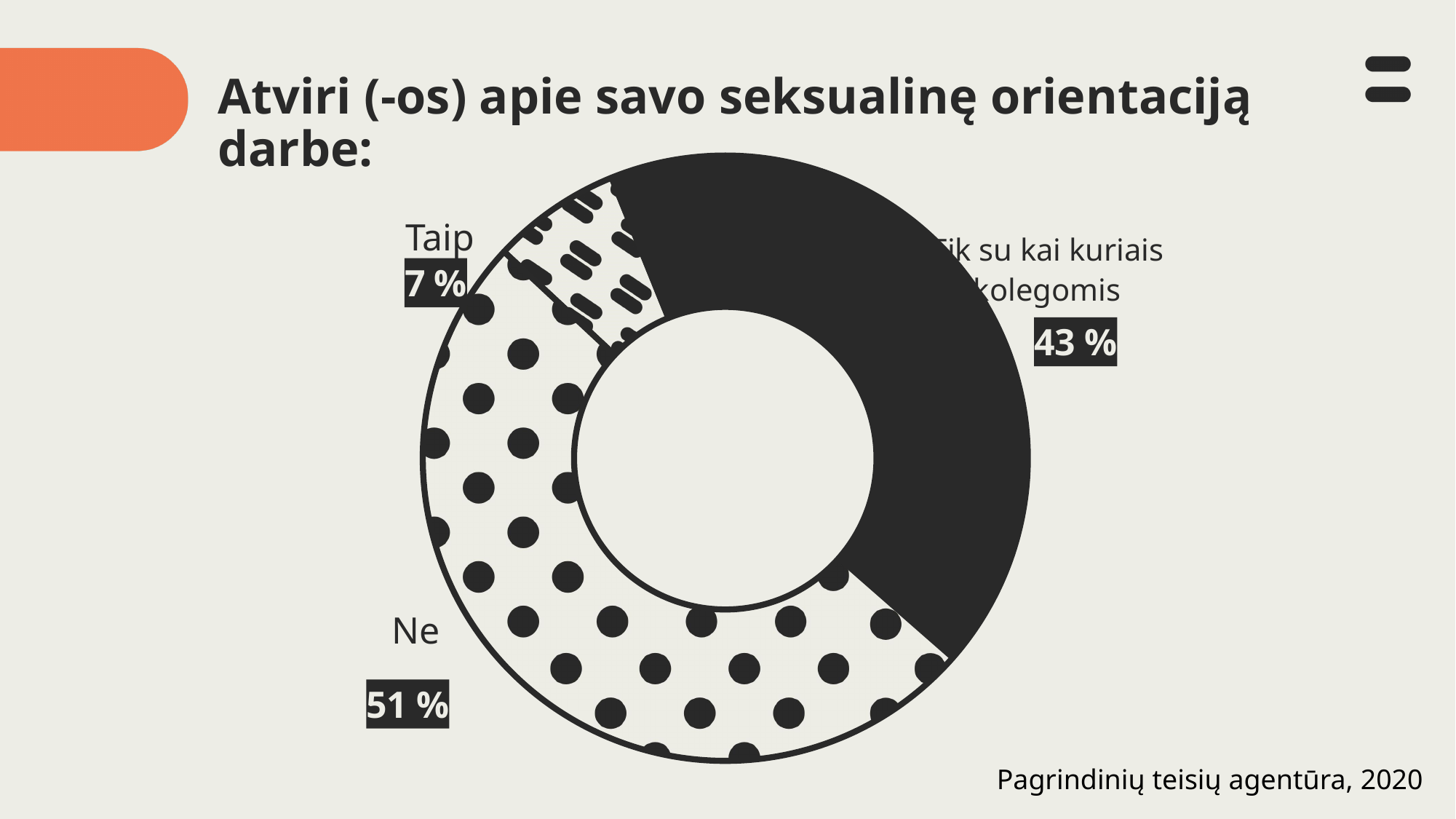
How many categories does the chart show? 3 What is the value for "Taip"? 7 % What is the value for "Ne"? 51 % Which is larger, the value for "Ne" or the value for "Taip"? Ne What is the title of the slide containing the chart? Atviri (-os) apie savo seksualinę orientaciją darbe: What kind of chart is shown on the slide? Pie chart (donut) What is the value for "Tik su kai kuriais kolegomis"? 43 % What source is cited for the chart data? Pagrindinių teisių agentūra, 2020 What is the difference between the values for "Ne" and "Tik su kai kuriais kolegomis"? 8 % Which category has the largest share? Ne What is the difference between the values for "Tik su kai kuriais kolegomis" and "Taip"? 36 % Which category has the smallest share? Taip